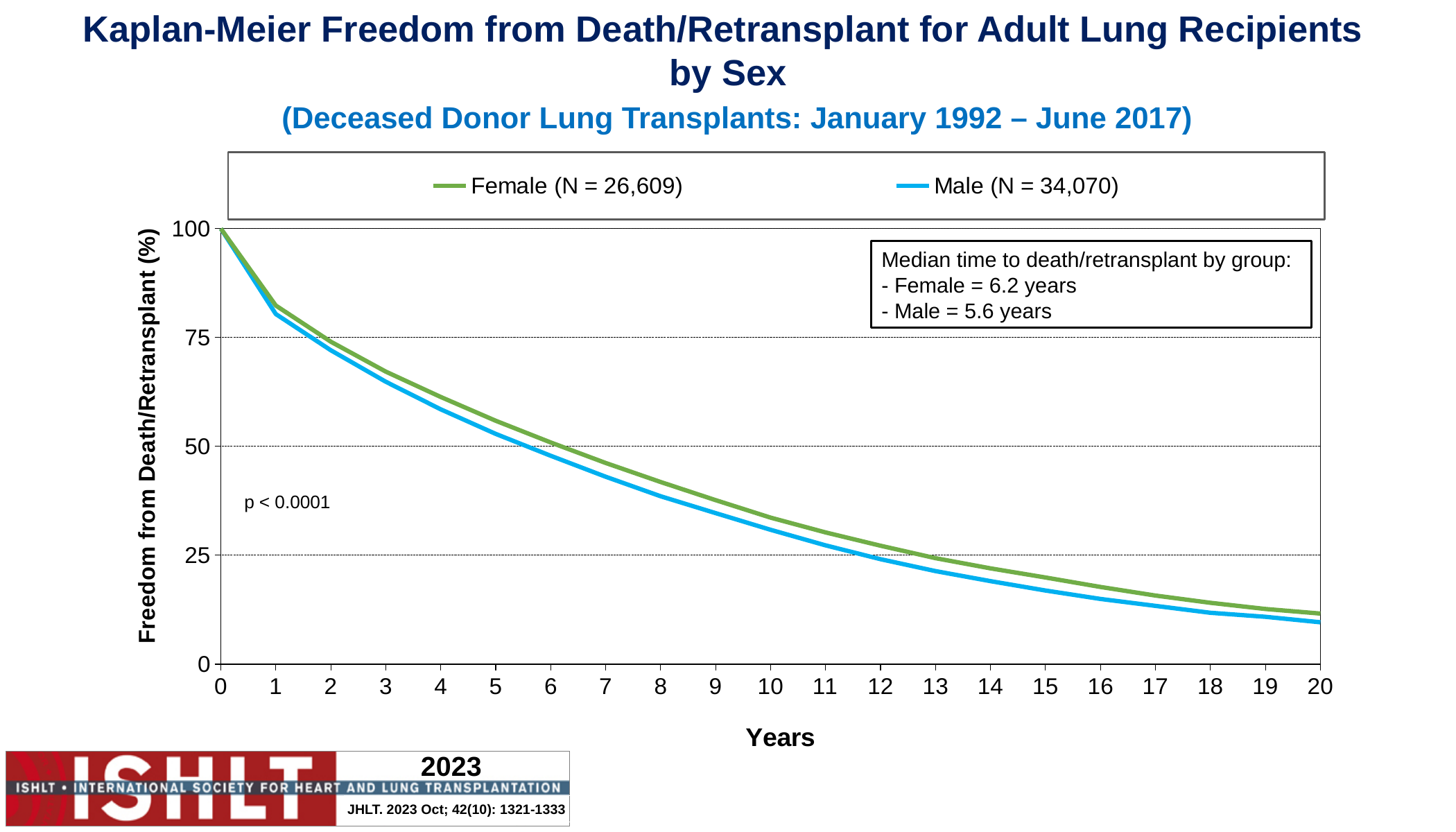
What is the median time to death/retransplant for the Female group? 6.2 years Do the curves rise or fall as the years increase along the x axis? Fall What kind of chart is shown on the slide? Line chart Is the Female freedom from death/retransplant at 15 years greater or less than 25? less Which group has the longer median time to death/retransplant, Female or Male? Female Is the Female freedom from death/retransplant at 10 years greater or less than 50? less What is the median time to death/retransplant for the Male group? 5.6 years Is the Male freedom from death/retransplant at 3 years greater or less than 50? greater What is the difference in median time to death/retransplant between the Female and Male groups? 0.6 years How many series does the legend list? 2 What is the N for the Male group shown in the legend? 34,070 At 10 years, which curve is higher, Female or Male? Female